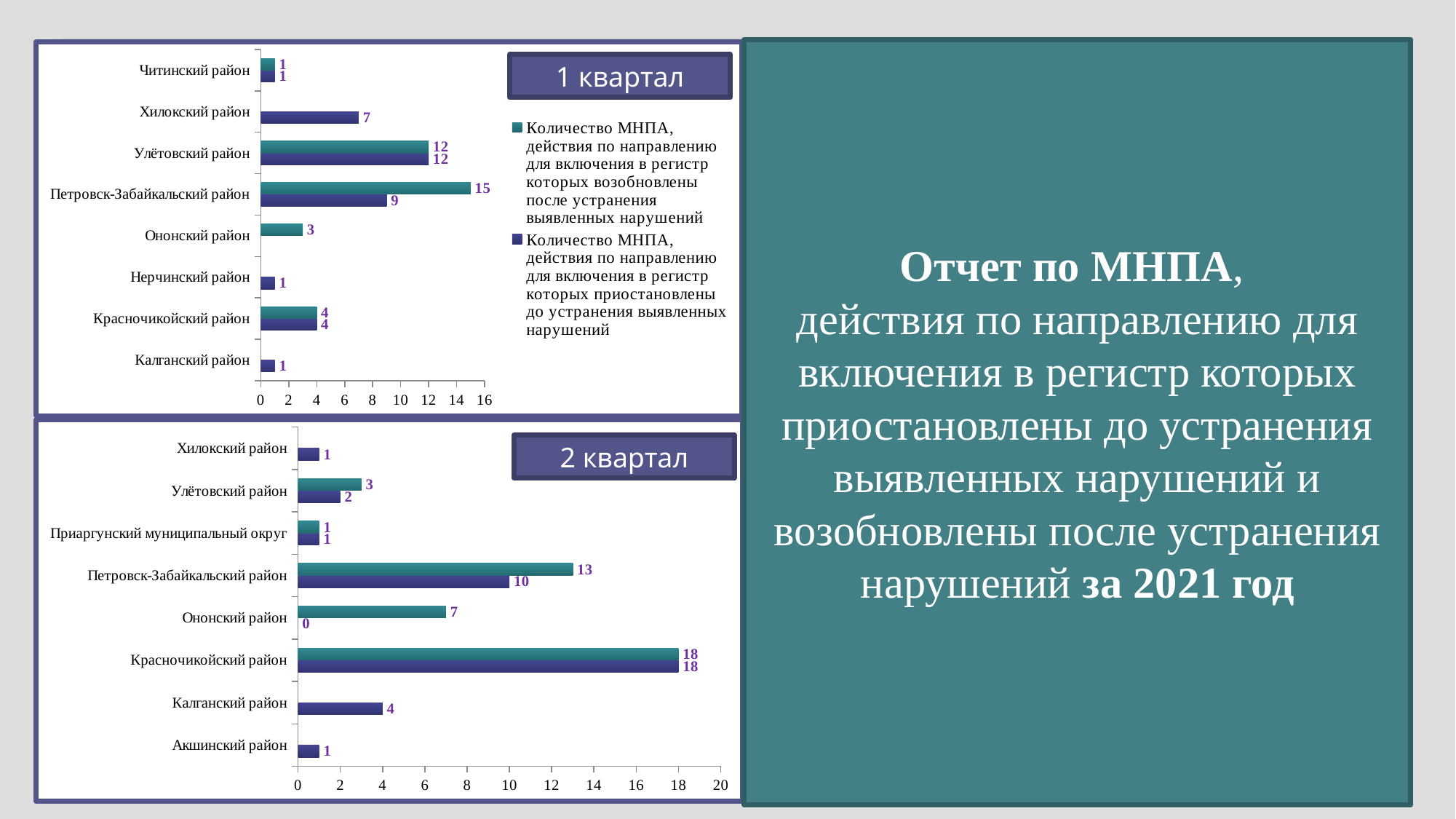
In the "1 квартал" chart, what is the value of the resumed (возобновлены) series for Петровск-Забайкальский район? 15 How many series does the legend of the "1 квартал" chart list? 2 In the "2 квартал" chart, what is the difference between the resumed value for Ононский район and the suspended value for Калганский район? 3 In the "1 квартал" chart, which district has the highest value for the resumed (возобновлены) series? Петровск-Забайкальский район In the "2 квартал" chart, what is the value of the suspended (приостановлены) series for Петровск-Забайкальский район? 10 In the "2 квартал" chart, which district has the highest value for the suspended (приостановлены) series? Красночикойский район In the "1 квартал" chart, what is the value of the suspended (приостановлены) series for Хилокский район? 7 In the "1 квартал" chart, how many districts are listed on the vertical axis? 8 In the "1 квартал" chart, what is the difference between the resumed and suspended values for Петровск-Забайкальский район? 6 In the "2 квартал" chart, what is the value of the resumed (возобновлены) series for Красночикойский район? 18 What type of chart is the "2 квартал" chart? bar chart In the "2 квартал" chart, which is larger for Петровск-Забайкальский район: the resumed value or the suspended value? the resumed value (13)